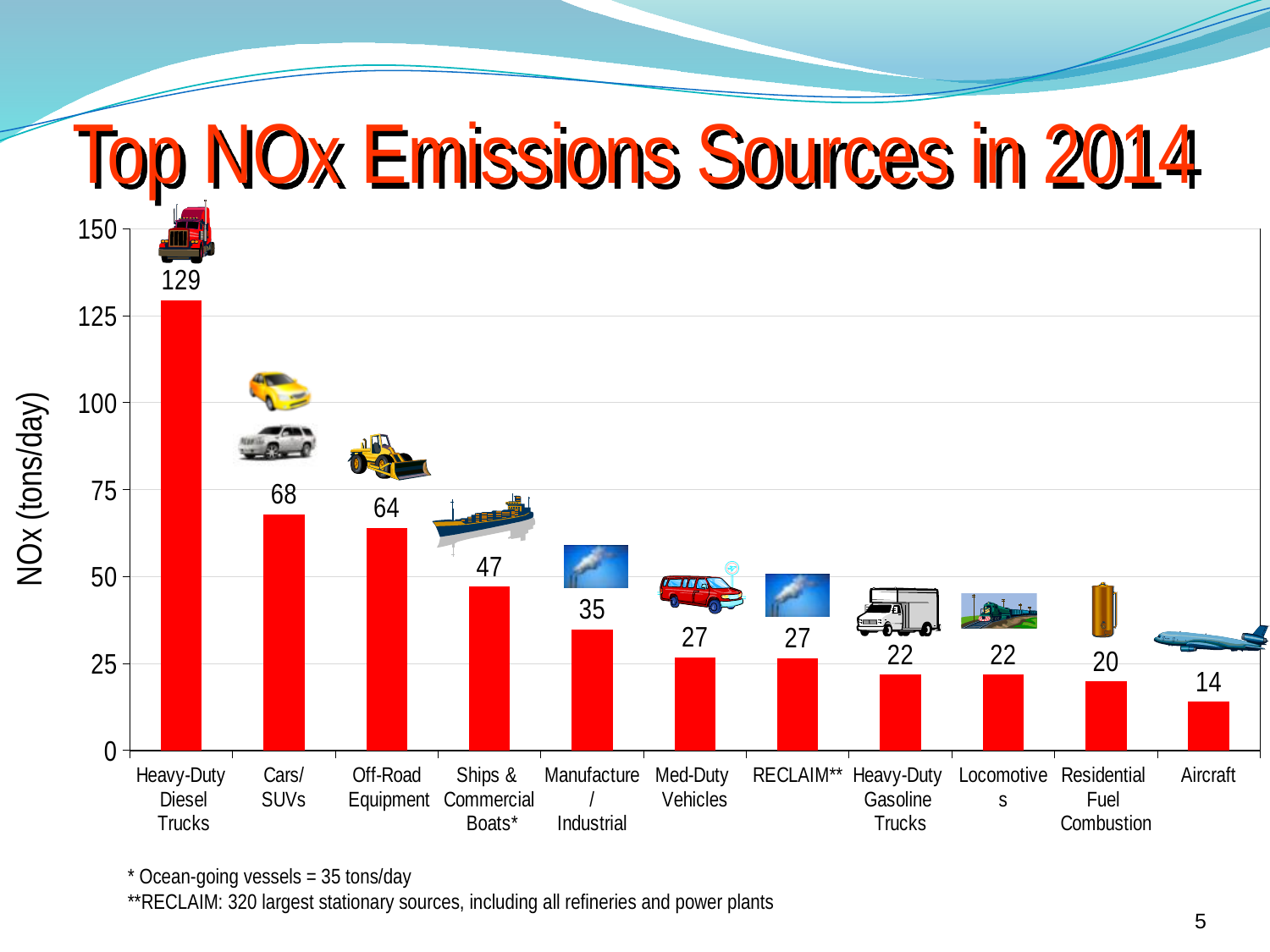
What is the NOx emissions value for Heavy-Duty Diesel Trucks? 129 Which source has the highest NOx emissions? Heavy-Duty Diesel Trucks Which has higher NOx emissions, Cars/SUVs or Off-Road Equipment? Cars/SUVs What is the NOx emissions value for Residential Fuel Combustion? 20 Is the value for Med-Duty Vehicles greater or less than 25? greater What is the NOx emissions value for Ships & Commercial Boats? 47 What is the difference in NOx emissions between Off-Road Equipment and Manufacture/Industrial? 29 What is the title of the chart? Top NOx Emissions Sources in 2014 How many emission sources are shown in the chart? 11 What type of chart is shown on the slide? bar chart What is the difference in NOx emissions between Heavy-Duty Diesel Trucks and Cars/SUVs? 61 Which source has the lowest NOx emissions? Aircraft